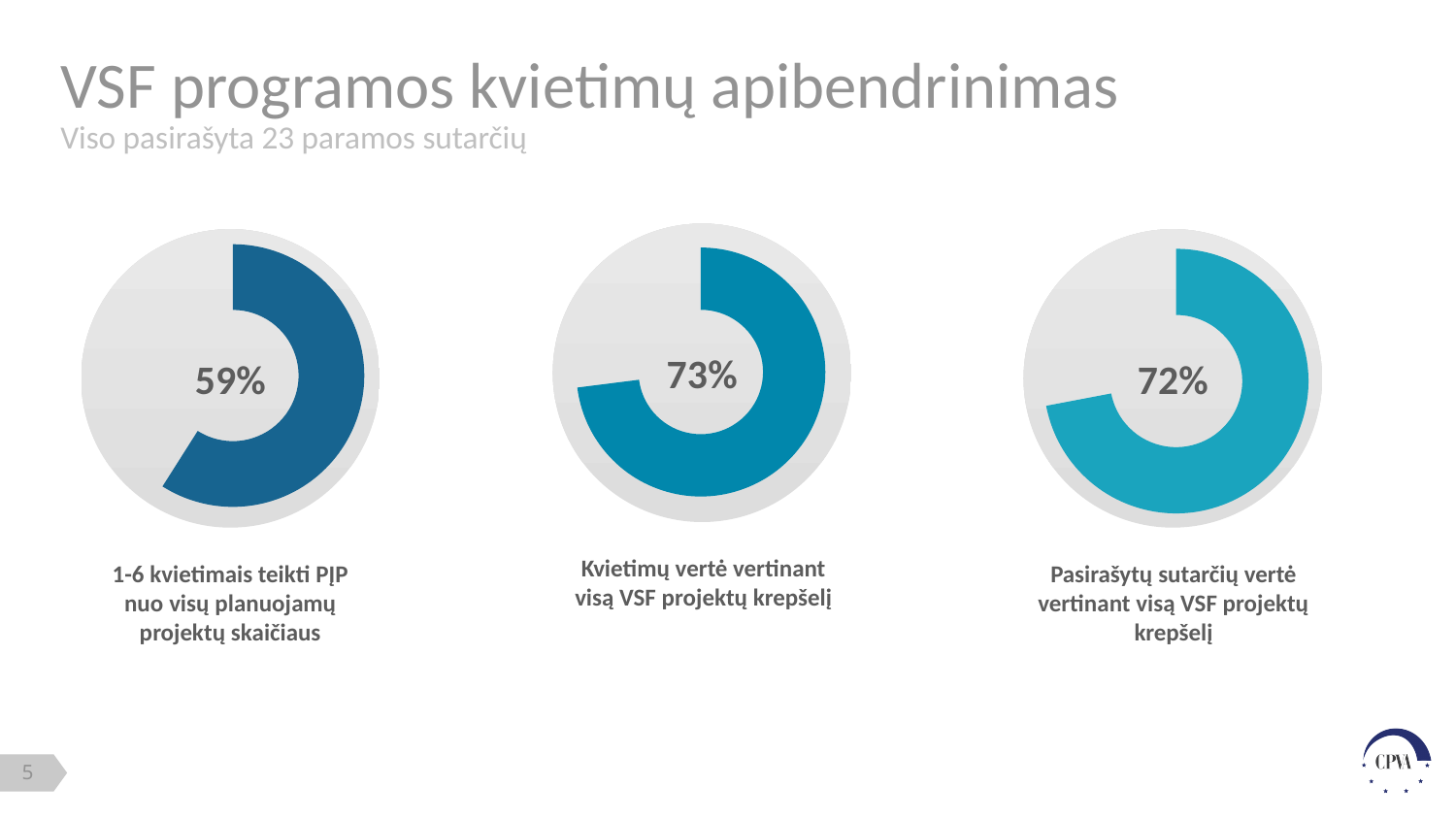
What percentage is shown in the left donut chart (1-6 kvietimais teikti PĮP nuo visų planuojamų projektų skaičiaus)? 59% What percentage is shown in the right donut chart (Pasirašytų sutarčių vertė vertinant visą VSF projektų krepšelį)? 72% Which is larger: the percentage in the middle chart (Kvietimų vertė) or the percentage in the right chart (Pasirašytų sutarčių vertė)? Middle chart (73%) Which of the three donut charts shows the lowest percentage? 1-6 kvietimais teikti PĮP nuo visų planuojamų projektų skaičiaus (59%) What is the difference in percentage points between the middle chart (73%) and the left chart (59%)? 14 percentage points How many donut charts are shown on the slide? 3 Which of the three donut charts shows the highest percentage? Kvietimų vertė vertinant visą VSF projektų krepšelį (73%) According to the slide subtitle, how many support contracts were signed in total? 23 What is the difference in percentage points between the middle chart (73%) and the right chart (72%)? 1 percentage point What percentage is shown in the middle donut chart (Kvietimų vertė vertinant visą VSF projektų krepšelį)? 73% What is the title of the slide? VSF programos kvietimų apibendrinimas What kind of chart is used for each of the three figures on the slide? Donut (pie) chart